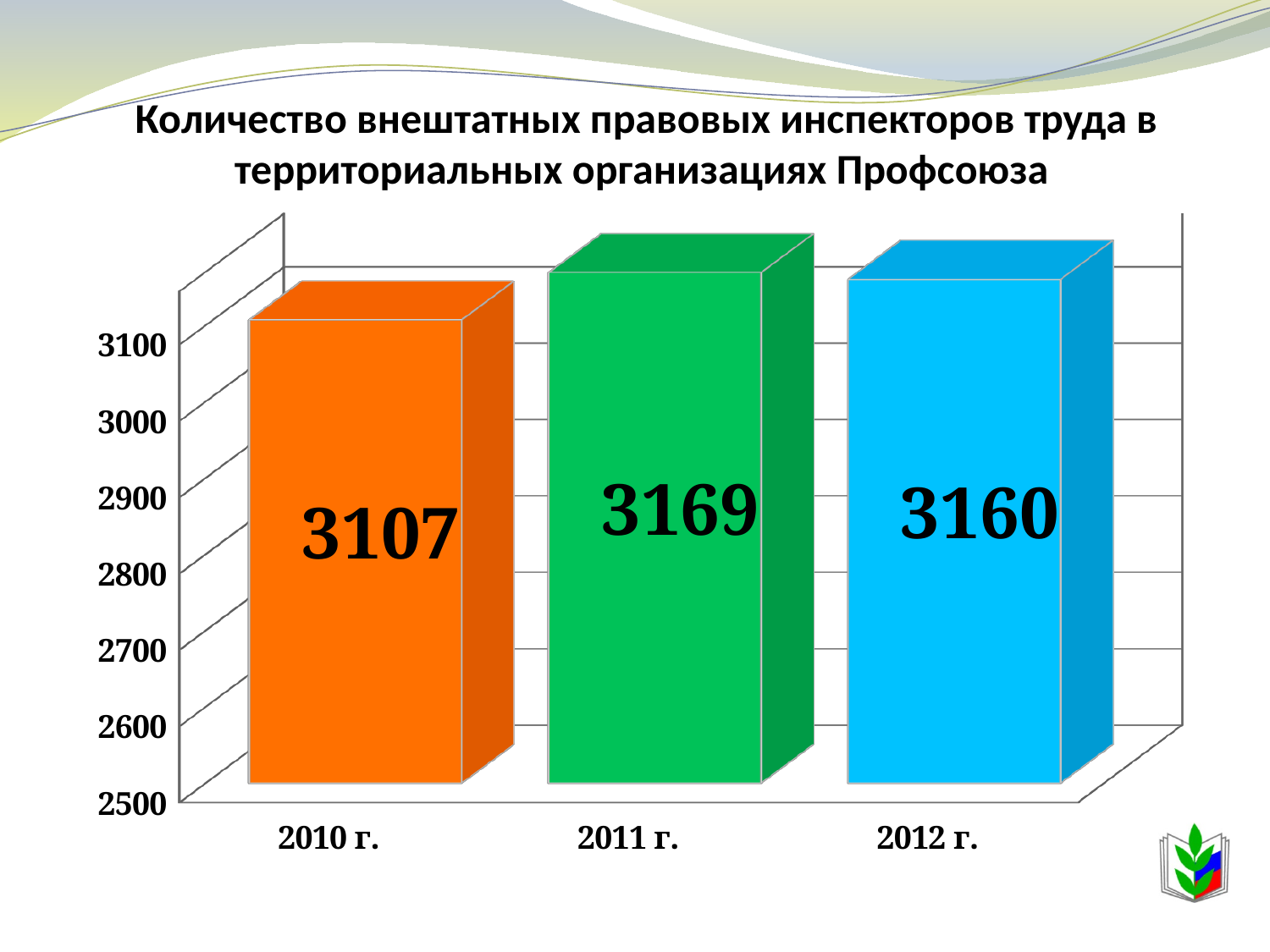
Which year has the lowest value? 2010 г. What kind of chart is shown on the slide? bar chart Which year has the highest value? 2011 г. What is the value for 2012 г.? 3160 Is the value for 2010 г. greater or less than 3000? greater Which is larger, the value for 2010 г. or the value for 2012 г.? 2012 г. How many years are shown on the chart? 3 What is the difference between the values for 2011 г. and 2012 г.? 9 What is the value for 2010 г.? 3107 What colour is the bar for 2011 г.? green What is the difference between the values for 2011 г. and 2010 г.? 62 What is the value for 2011 г.? 3169